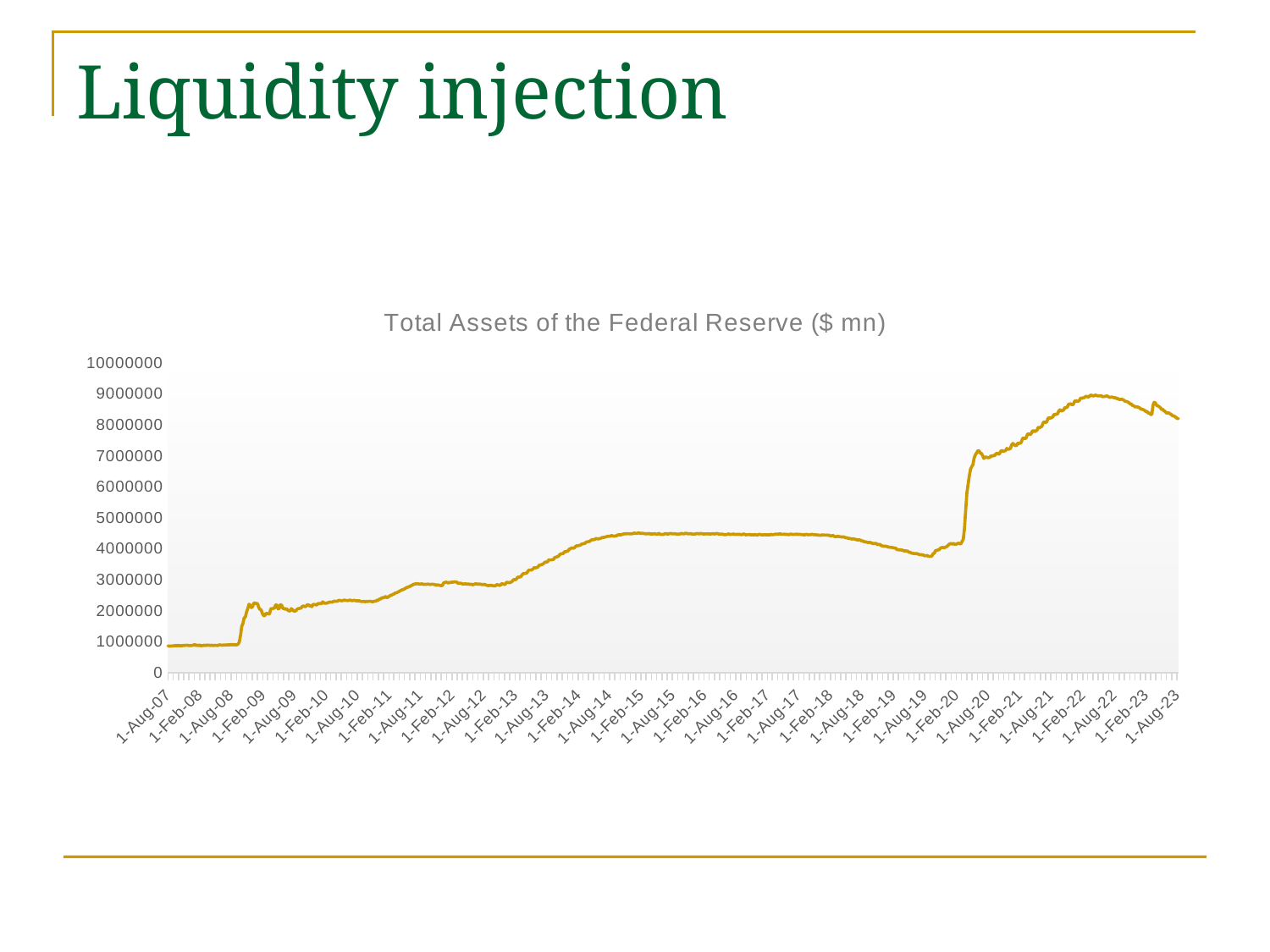
Is the value for 1-Feb-13 greater or less than 4000000? less Is the value for 1-Aug-15 greater or less than 4000000? greater How many lines are plotted on the chart? 1 Is the value for 1-Aug-22 greater or less than 8000000? greater What kind of chart is shown on the slide? line chart Which is larger, the value for 1-Aug-15 or the value for 1-Aug-10? 1-Aug-15 Overall, do the values rise or fall from 1-Aug-07 to 1-Aug-23? rise Do the values rise or fall between 1-Aug-22 and 1-Aug-23? fall Which is larger, the value for 1-Aug-22 or the value for 1-Aug-07? 1-Aug-22 What is the title of the chart? Total Assets of the Federal Reserve ($ mn)